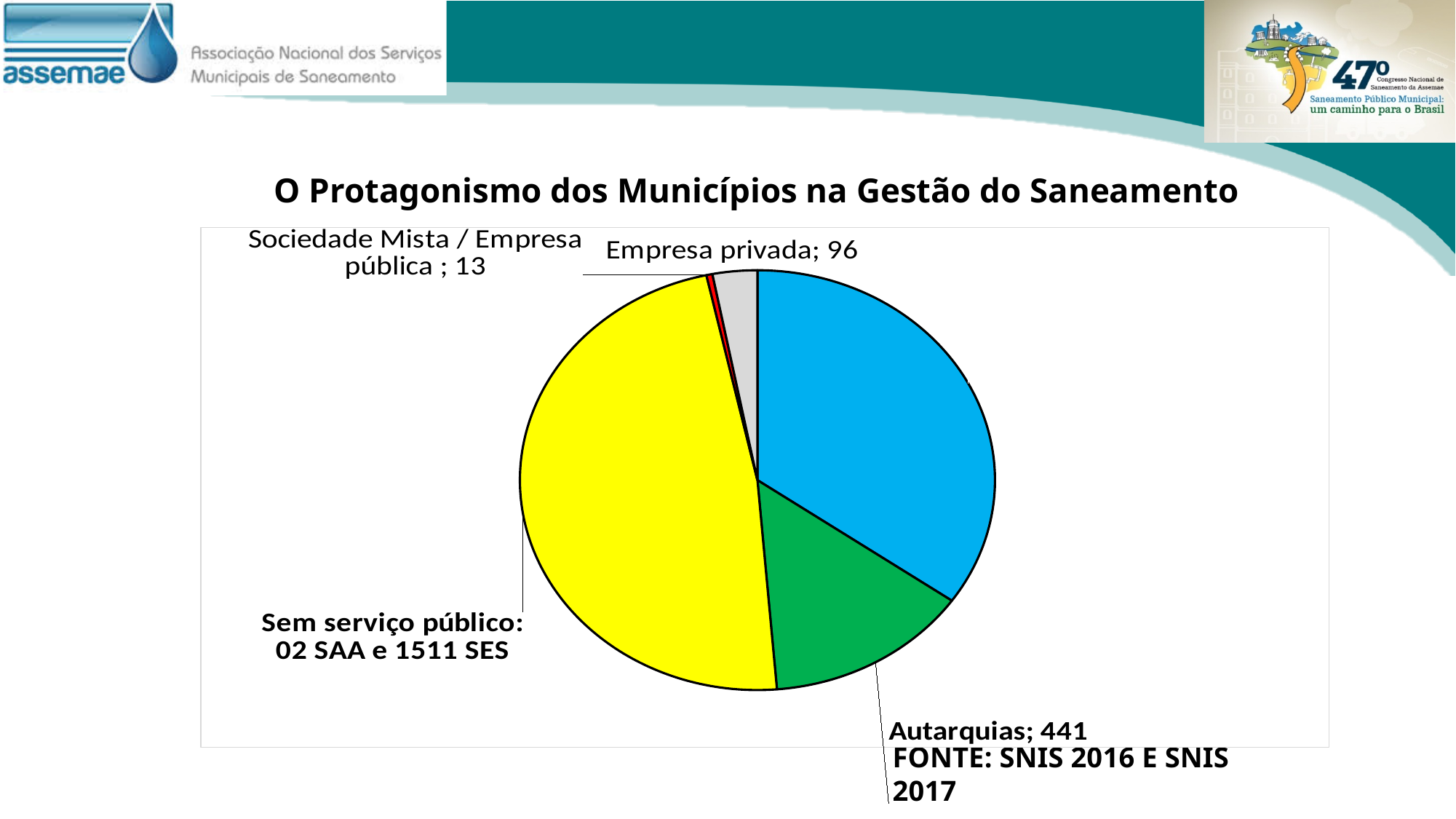
What is the difference between the values for Autarquias and Empresa privada? 345 What is the difference between the values for Empresa privada and Sociedade Mista / Empresa pública? 83 How many slices does the pie chart have? 5 What value is shown for Sociedade Mista / Empresa pública in the pie chart? 13 Which slice of the pie chart is the largest? Sem serviço público What value is shown for Autarquias in the pie chart? 441 What colour is the Autarquias slice in the pie chart? Green Which slice of the pie chart is the smallest? Sociedade Mista / Empresa pública Which slice is larger, Sem serviço público or Autarquias? Sem serviço público What kind of chart is shown on the slide? Pie chart What value is shown for Empresa privada in the pie chart? 96 Which is larger in the pie chart, Autarquias or Empresa privada? Autarquias